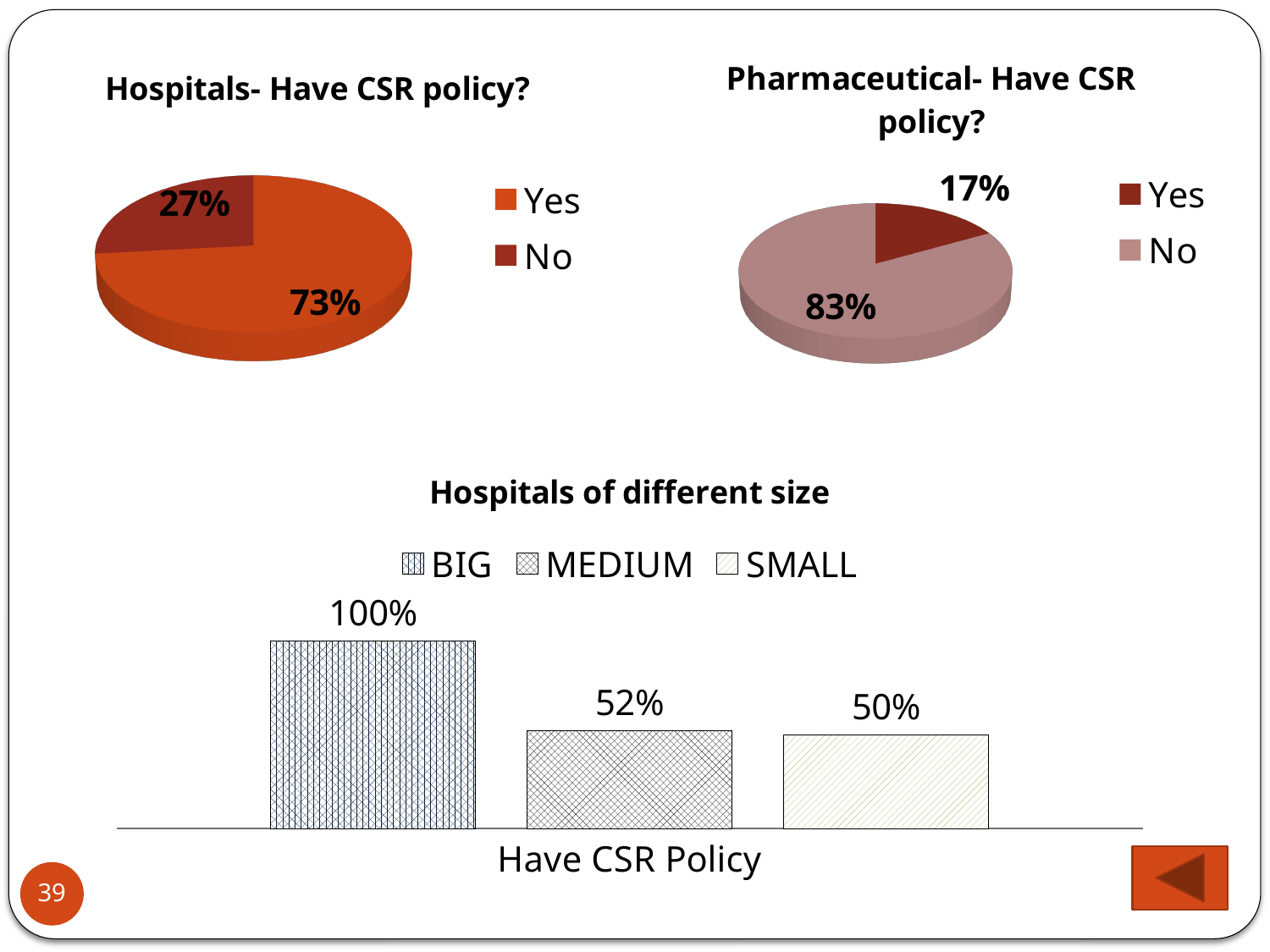
In the 'Hospitals of different size' chart, what is the difference between the BIG and SMALL values? 50% What kind of chart is 'Hospitals- Have CSR policy?' Pie chart In the 'Hospitals of different size' chart, what is the value for MEDIUM hospitals? 52% In the 'Pharmaceutical- Have CSR policy?' chart, which slice is larger, Yes or No? No In the 'Pharmaceutical- Have CSR policy?' chart, what percentage answered No? 83% In the 'Hospitals- Have CSR policy?' chart, what percentage answered No? 27% In the 'Pharmaceutical- Have CSR policy?' chart, what percentage answered Yes? 17% In the 'Hospitals of different size' chart, what is the value for BIG hospitals? 100% In the 'Hospitals of different size' chart, which hospital size has the lowest value? SMALL In the 'Hospitals- Have CSR policy?' chart, what is the difference between the Yes and No shares? 46% How many series does the legend of the 'Hospitals of different size' chart list? 3 In the 'Hospitals- Have CSR policy?' chart, what percentage of hospitals answered Yes? 73%